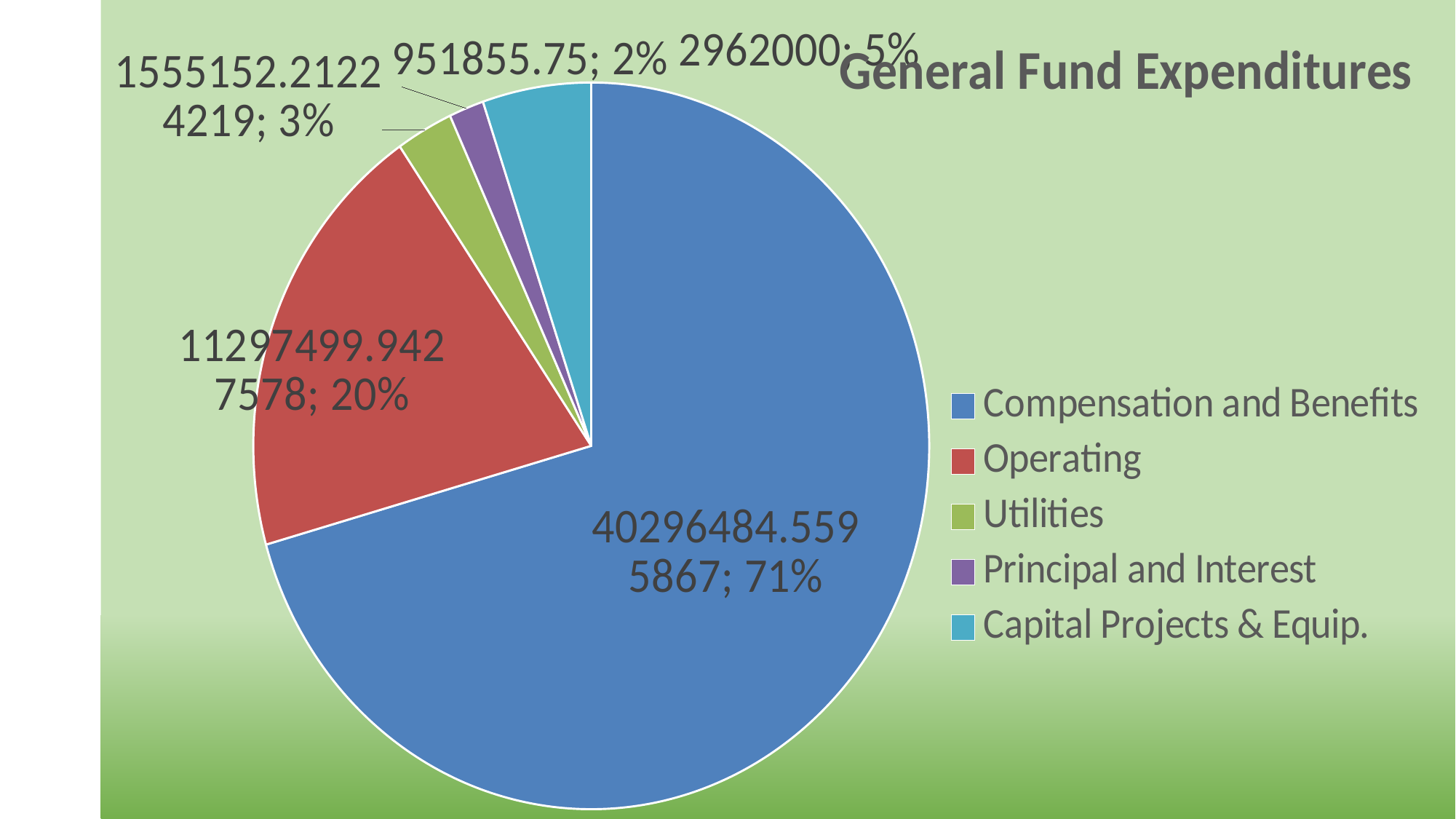
What share of the pie does Principal and Interest represent? 2% Which is larger, the Operating slice or the Utilities slice? Operating What is the value shown for Principal and Interest? 951855.75 What share of the pie does Capital Projects & Equip. represent? 5% Which category has the largest slice of the pie? Compensation and Benefits What kind of chart is shown on the slide? pie chart Which category has the smallest slice of the pie? Principal and Interest How many categories does the legend list? 5 What share of the pie does Operating represent? 20% What is the title of the chart? General Fund Expenditures